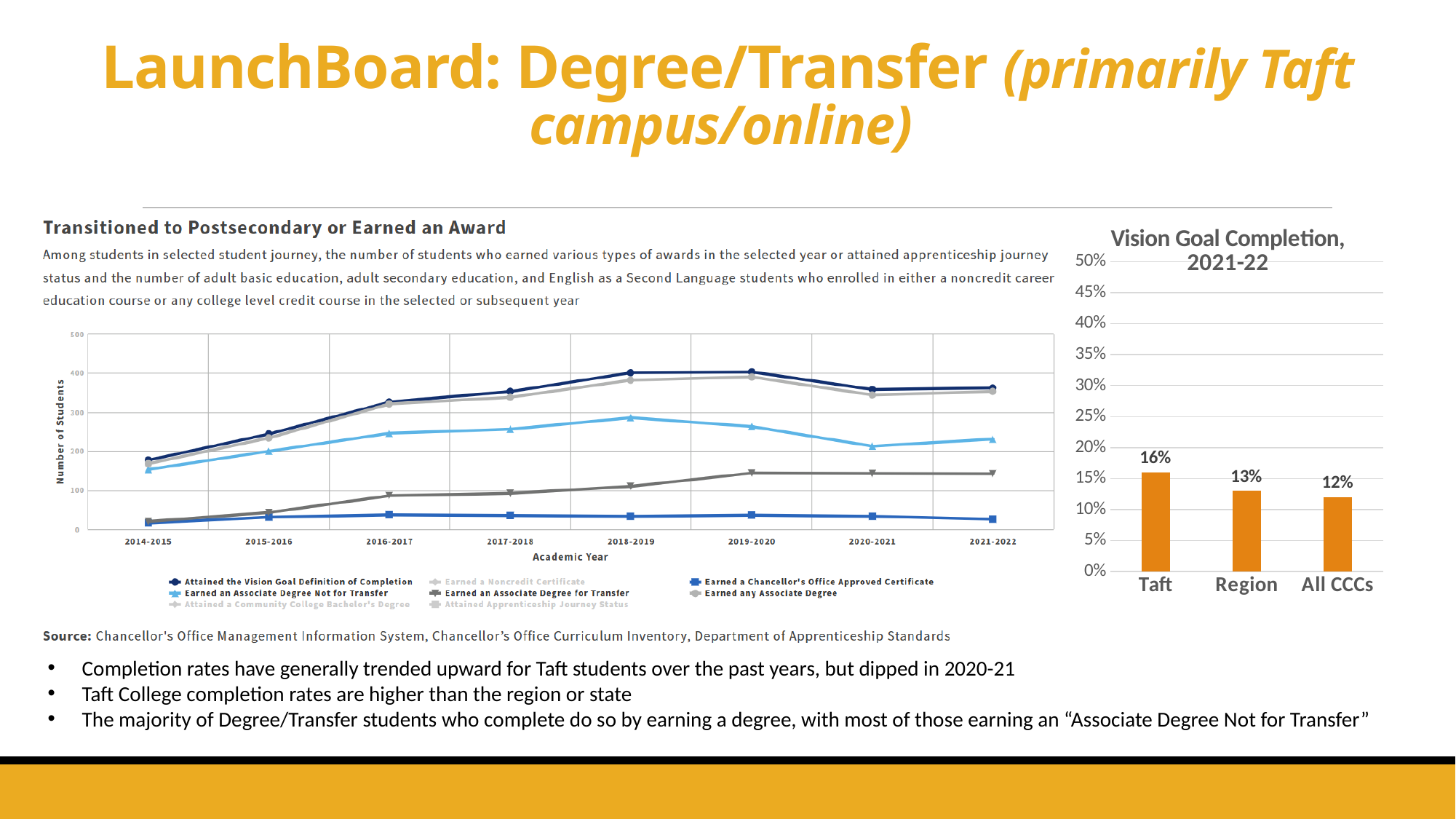
In the Vision Goal Completion, 2021-22 chart, what is the value for All CCCs? 12% In the Transitioned to Postsecondary or Earned an Award chart, how many academic years are shown on the x axis? 8 In the Vision Goal Completion, 2021-22 chart, what is the value for Region? 13% In the Vision Goal Completion, 2021-22 chart, which category has the highest value? Taft What kind of chart is the Vision Goal Completion, 2021-22 chart? Bar chart In the Vision Goal Completion, 2021-22 chart, which category has the lowest value? All CCCs In the Vision Goal Completion, 2021-22 chart, what is the value for Taft? 16% In the Vision Goal Completion, 2021-22 chart, what is the difference between the Taft value and the All CCCs value? 4% In the Transitioned to Postsecondary or Earned an Award chart, is the value for Attained the Vision Goal Definition of Completion in 2014-2015 greater or less than 200? less What kind of chart is the Transitioned to Postsecondary or Earned an Award chart? Line chart In the Vision Goal Completion, 2021-22 chart, how many categories are shown? 3 In the Transitioned to Postsecondary or Earned an Award chart, is the value for Earned an Associate Degree for Transfer in 2019-2020 greater or less than 100? greater